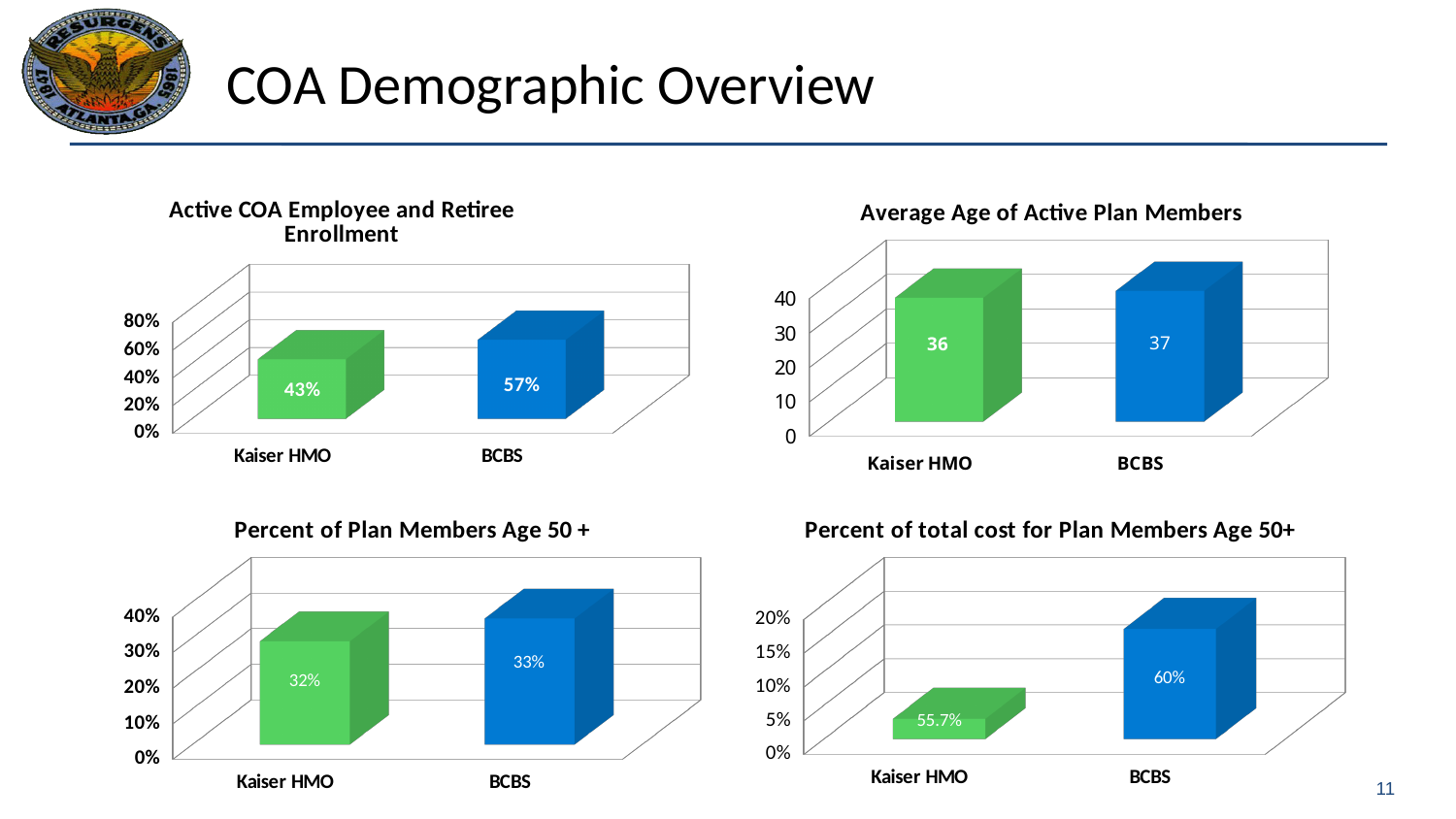
In the 'Percent of Plan Members Age 50 +' chart, what is the value for BCBS? 33% In the 'Active COA Employee and Retiree Enrollment' chart, which category has the higher value? BCBS In the 'Active COA Employee and Retiree Enrollment' chart, what is the value for Kaiser HMO? 43% In the 'Percent of total cost for Plan Members Age 50+' chart, what is the value labelled for BCBS? 60% In the 'Active COA Employee and Retiree Enrollment' chart, what is the difference between BCBS and Kaiser HMO? 14% In the 'Percent of Plan Members Age 50 +' chart, what is the value for Kaiser HMO? 32% In the 'Average Age of Active Plan Members' chart, what is the difference between BCBS and Kaiser HMO? 1 How many charts are shown on the slide? 4 In the 'Active COA Employee and Retiree Enrollment' chart, what is the value for BCBS? 57% In the 'Percent of total cost for Plan Members Age 50+' chart, which category has the larger value, Kaiser HMO or BCBS? BCBS In the 'Average Age of Active Plan Members' chart, what is the value for Kaiser HMO? 36 In the 'Average Age of Active Plan Members' chart, what is the value for BCBS? 37